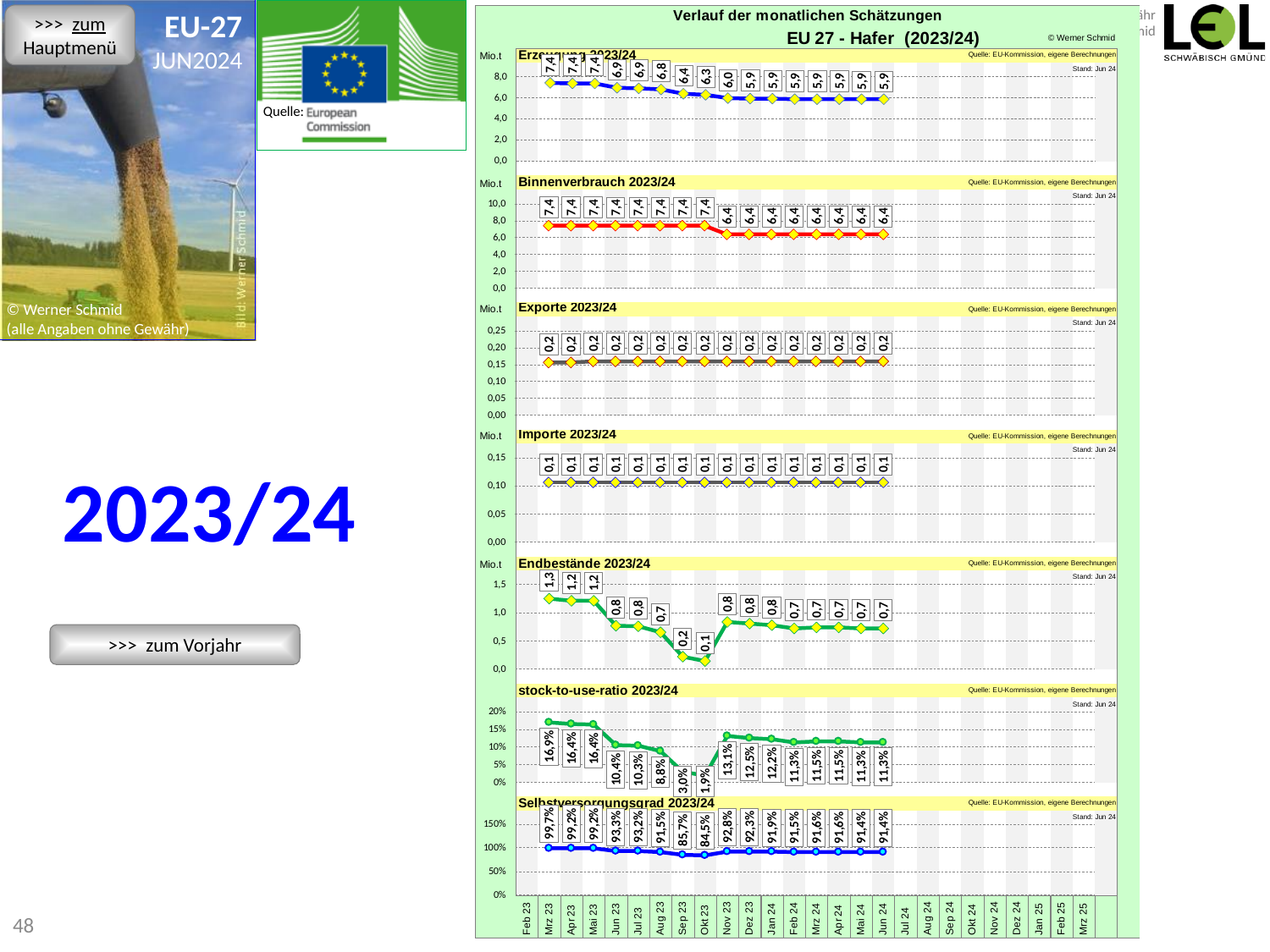
In the stock-to-use-ratio 2023/24 chart, which month has the highest value? Mrz 23 In the Binnenverbrauch 2023/24 chart, what is the value for Jun 24? 6,4 In the Selbstversorgungsgrad 2023/24 chart, what is the value for Jun 24? 91,4% In the Erzeugung 2023/24 chart, do the values rise or fall from Mrz 23 to Jun 24? fall In the Endbestände 2023/24 chart, what is the value for Mrz 23? 1,3 In the Selbstversorgungsgrad 2023/24 chart, which month has the lowest value? Okt 23 What kind of chart is the Erzeugung 2023/24 chart? line chart In the Endbestände 2023/24 chart, which month has the lowest value? Okt 23 In the stock-to-use-ratio 2023/24 chart, what is the value for Okt 23? 1,9% In the Erzeugung 2023/24 chart, what is the value for Mrz 23? 7,4 In the Erzeugung 2023/24 chart, what is the value for Jun 24? 5,9 In the Erzeugung 2023/24 chart, what is the difference between the value for Mrz 23 and the value for Jun 24? 1,5